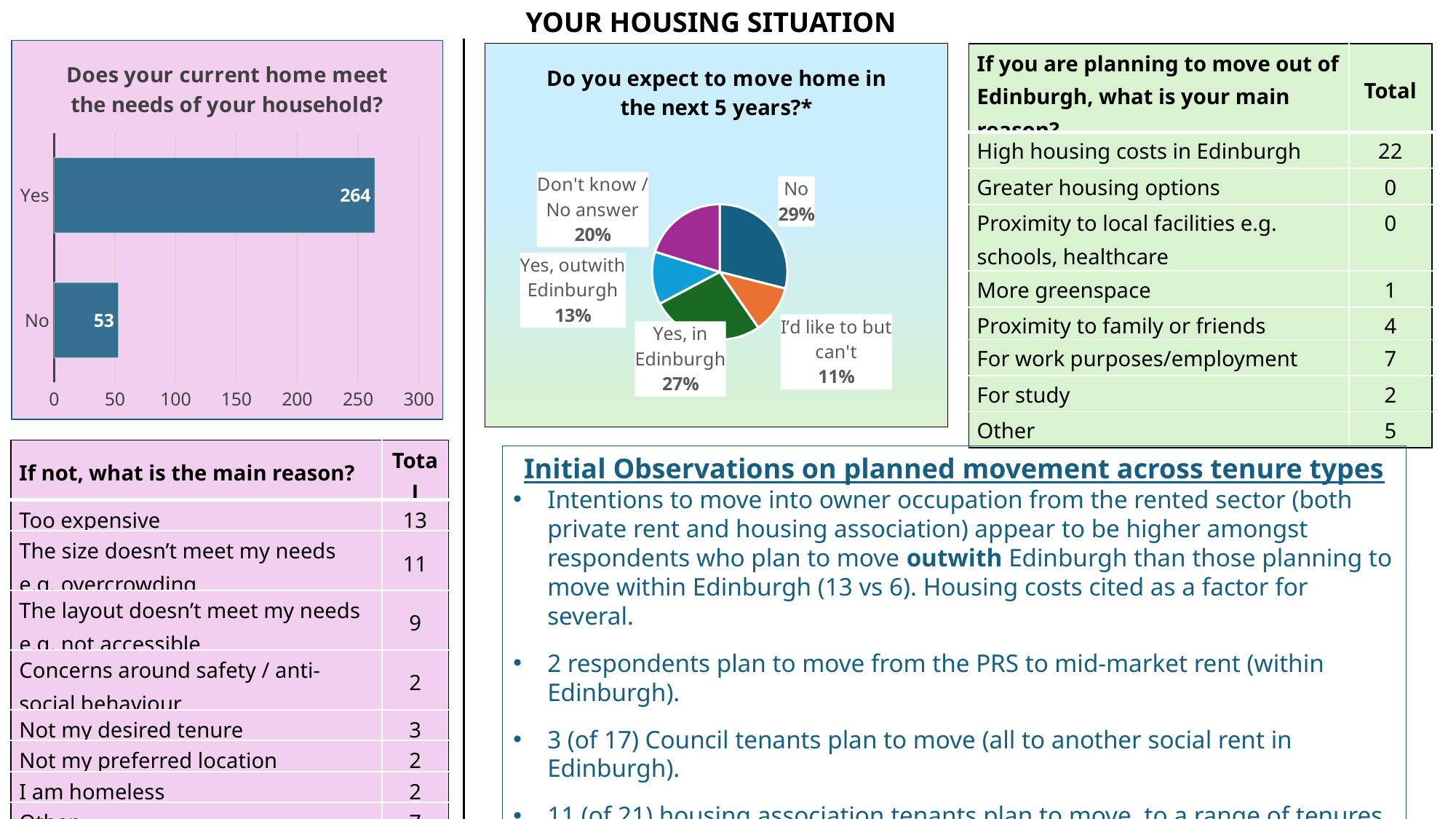
In the pie chart 'Do you expect to move home in the next 5 years?', what share answered 'I'd like to but can't'? 11% In the chart 'Does your current home meet the needs of your household?', what is the value for No? 53 How many categories are shown in the chart 'Does your current home meet the needs of your household?'? 2 In the pie chart 'Do you expect to move home in the next 5 years?', what share answered 'Yes, in Edinburgh'? 27% In the chart 'Does your current home meet the needs of your household?', what is the value for Yes? 264 What kind of chart is 'Does your current home meet the needs of your household?'? Bar chart In the pie chart 'Do you expect to move home in the next 5 years?', what share of respondents answered No? 29% In the chart 'Does your current home meet the needs of your household?', is the value for Yes greater or less than 250? greater In the pie chart 'Do you expect to move home in the next 5 years?', which response has the smallest share? I'd like to but can't How many slices does the pie chart 'Do you expect to move home in the next 5 years?' have? 5 In the chart 'Does your current home meet the needs of your household?', what is the difference between the Yes and No values? 211 In the pie chart 'Do you expect to move home in the next 5 years?', which is larger: 'Yes, outwith Edinburgh' or 'Don't know / No answer'? Don't know / No answer